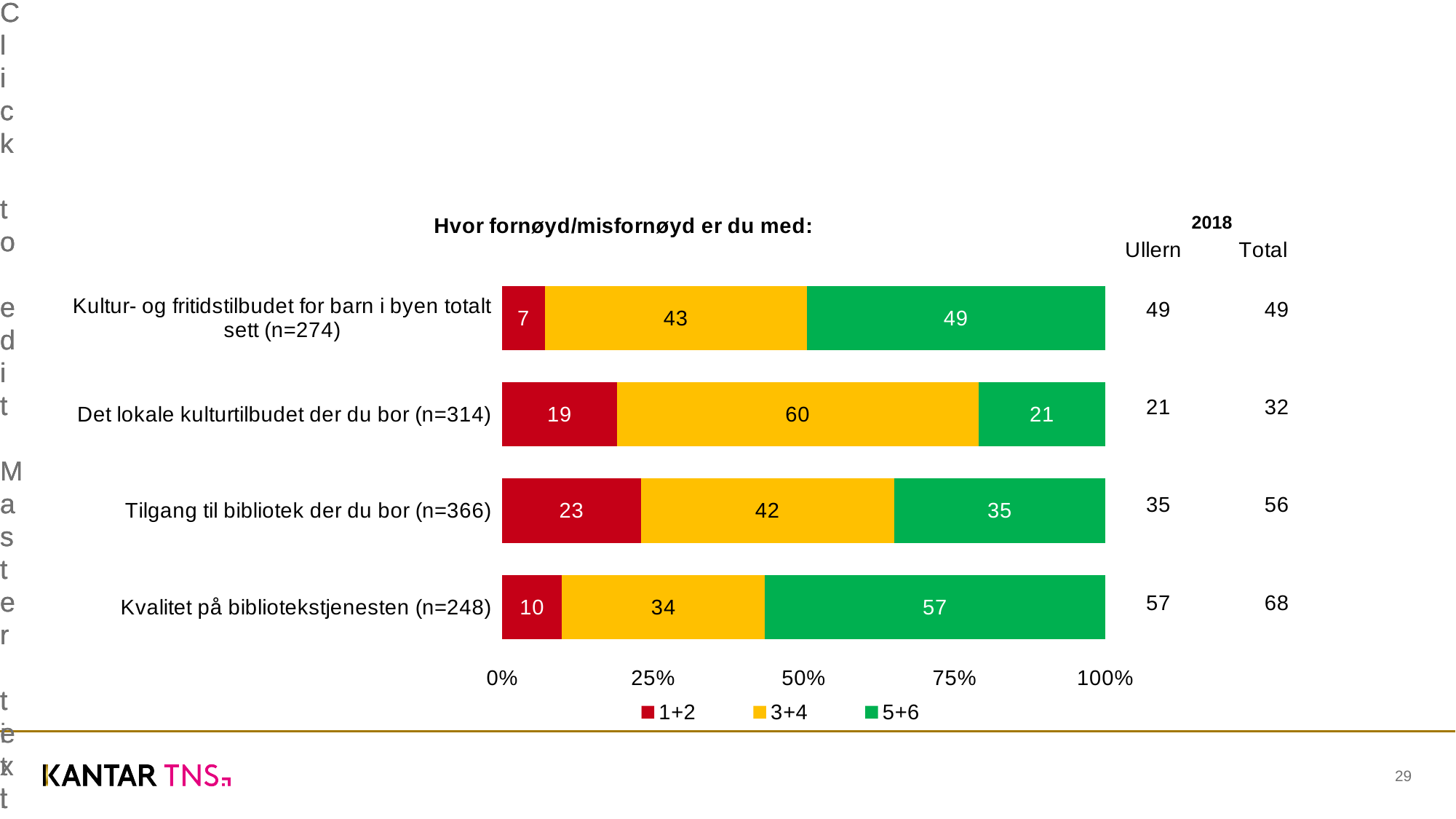
Which is larger: the 3+4 value for "Kultur- og fritidstilbudet for barn i byen totalt sett (n=274)" or the 3+4 value for "Tilgang til bibliotek der du bor (n=366)"? Kultur- og fritidstilbudet for barn i byen totalt sett (n=274) Which category has the lowest value for the 1+2 series? Kultur- og fritidstilbudet for barn i byen totalt sett (n=274) What is the value of the 3+4 series for "Det lokale kulturtilbudet der du bor (n=314)"? 60 Which category has the highest value for the 5+6 series? Kvalitet på bibliotekstjenesten (n=248) How many categories are shown in the chart? 4 What is the title of the chart? Hvor fornøyd/misfornøyd er du med: What kind of chart is shown on the slide? Stacked bar chart What is the value of the 5+6 series for "Kvalitet på bibliotekstjenesten (n=248)"? 57 How many series does the legend list? 3 What is the difference between the 5+6 values for "Kvalitet på bibliotekstjenesten (n=248)" and "Det lokale kulturtilbudet der du bor (n=314)"? 36 What is the total of the stacked bar for "Det lokale kulturtilbudet der du bor (n=314)"? 100 What is the value of the 1+2 series for "Tilgang til bibliotek der du bor (n=366)"? 23